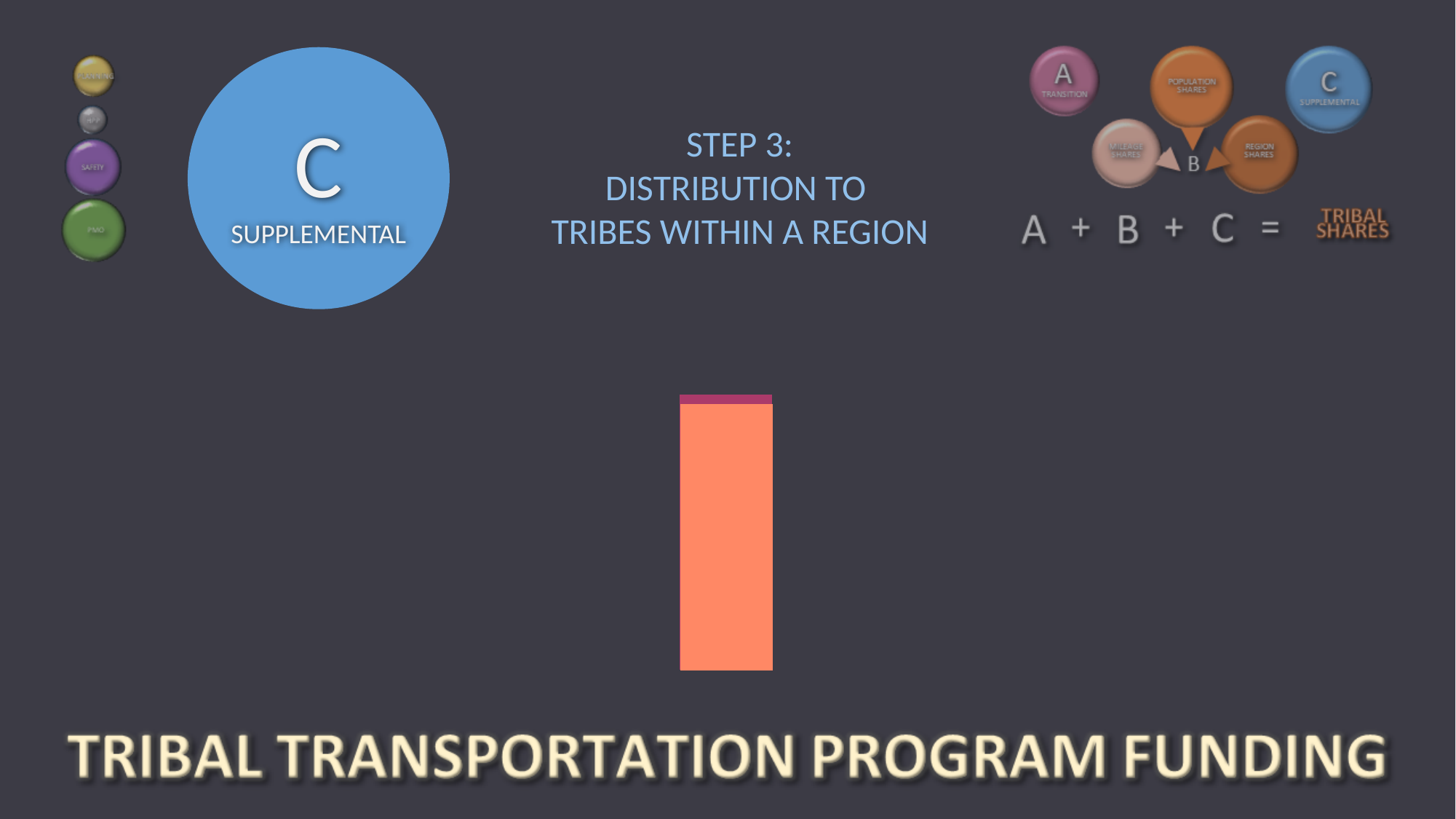
Does the chart on the slide display a legend? No What kind of chart is shown in the middle of the slide? bar chart Which segment of the bar is larger, the orange segment or the thin magenta segment at the top? the orange segment What colour is the large lower segment of the bar on the chart? orange How many coloured segments make up the single bar on the chart? 2 How many bars does the chart on the slide contain? 1